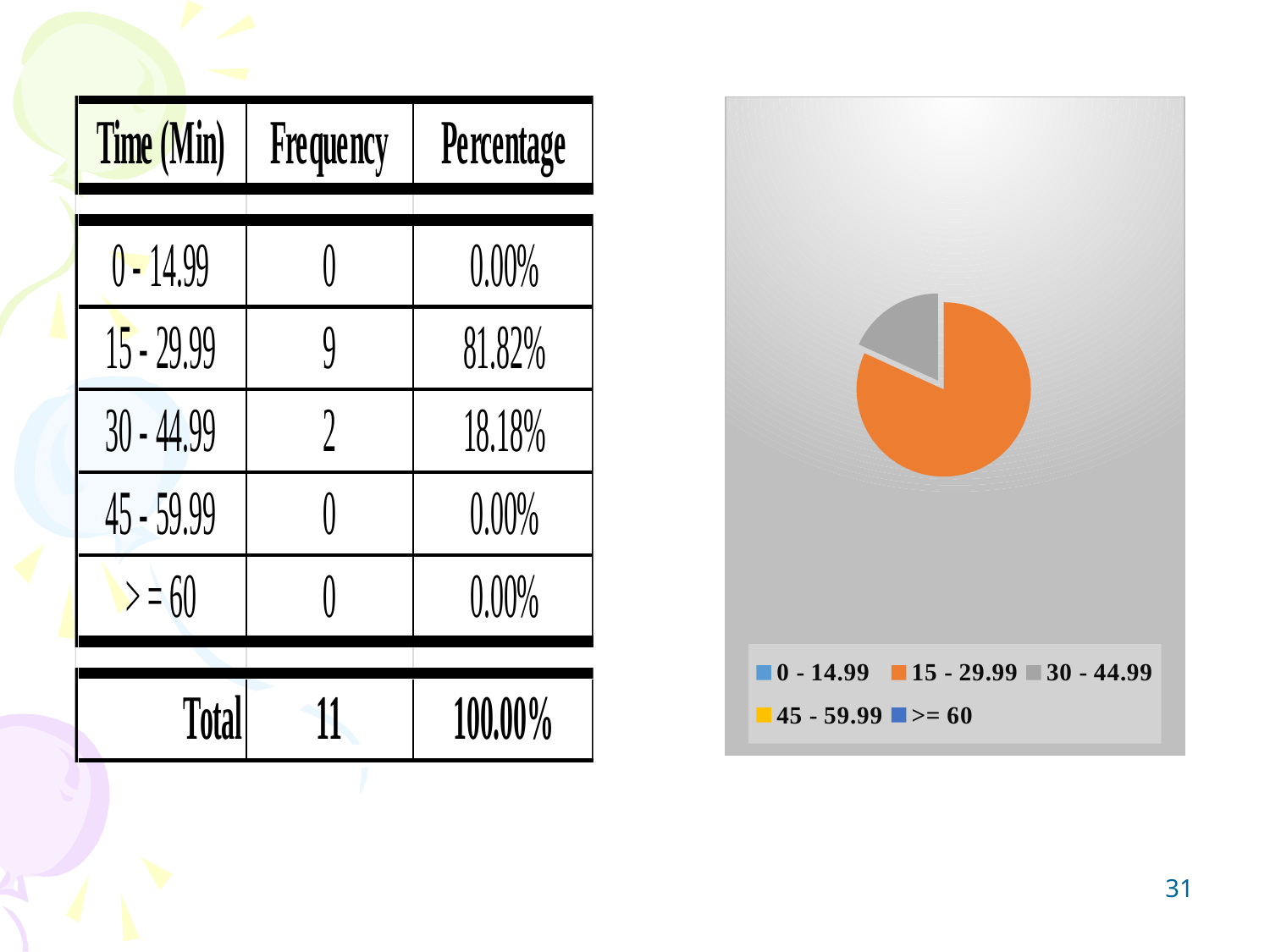
According to the table on the slide, what is the total frequency across all time intervals? 11 Which slice is larger in the pie chart, 15 - 29.99 or 30 - 44.99? 15 - 29.99 How many slices are visible in the pie chart? 2 Which category has the largest slice in the pie chart? 15 - 29.99 What kind of chart is shown on the right of the slide? pie chart According to the table on the slide, what is the frequency for the 30 - 44.99 time interval? 2 According to the table on the slide, what share of the pie does the 30 - 44.99 category represent? 18.18% What colour is the largest slice of the pie chart? orange According to the table on the slide, what share of the pie does the 15 - 29.99 category represent? 81.82% What colour does the legend assign to the 30 - 44.99 category? grey How many categories does the pie chart's legend list? 5 According to the table on the slide, what is the frequency for the 15 - 29.99 time interval? 9